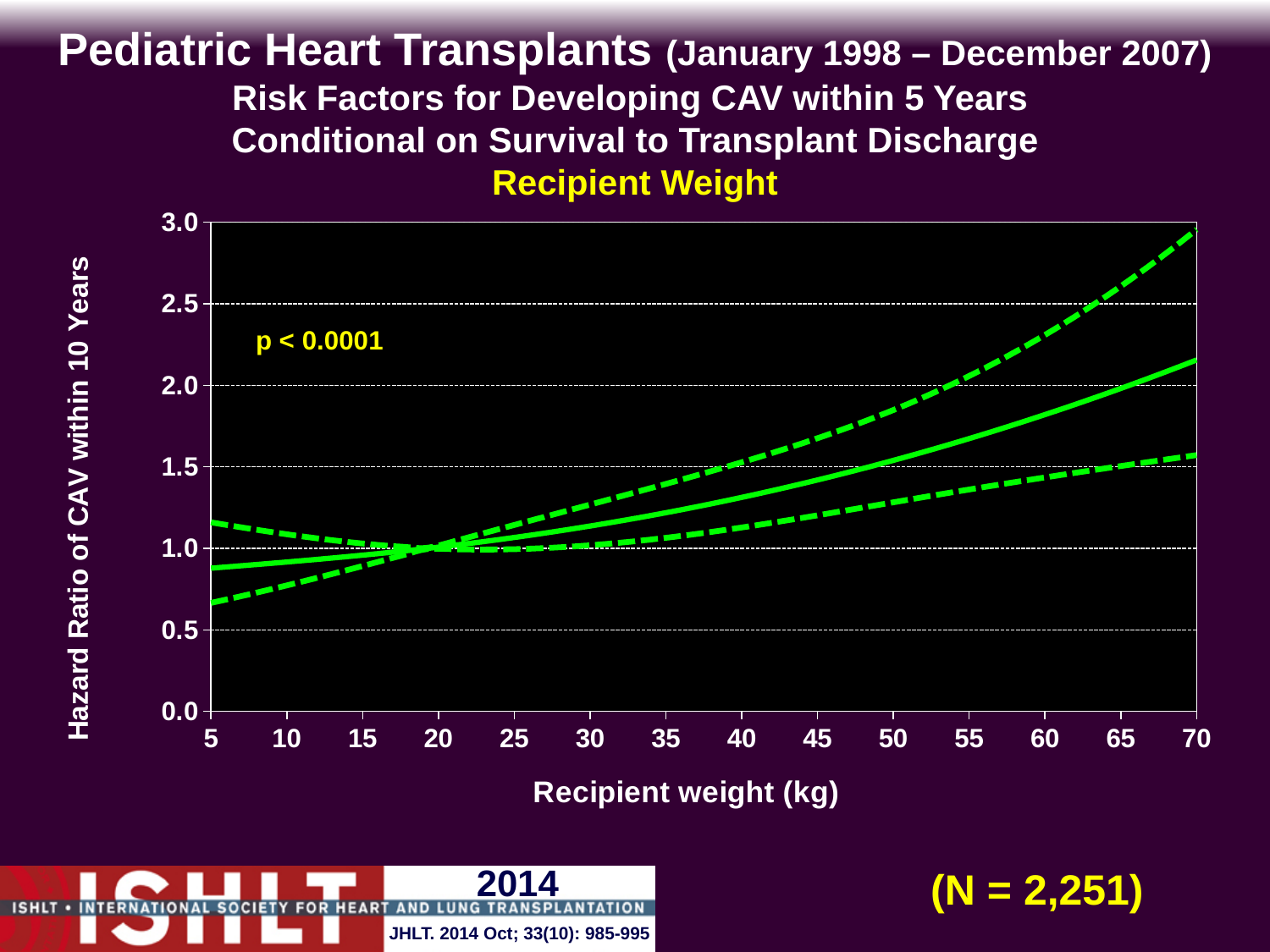
Is the value of the upper dashed line at a recipient weight of 70 kg greater or less than 2.5? greater What is the label of the x axis? Recipient weight (kg) Is the value of the lower dashed line at a recipient weight of 5 kg greater or less than 1.0? less Does the solid line for hazard ratio rise or fall as recipient weight increases from 5 kg to 70 kg? rise What is the highest value shown on the y axis? 3.0 How many lines are plotted on the chart? 3 Is the value of the solid line at a recipient weight of 40 kg greater or less than 1.5? less What p-value is printed on the chart? p < 0.0001 What kind of chart is shown on the slide? line chart